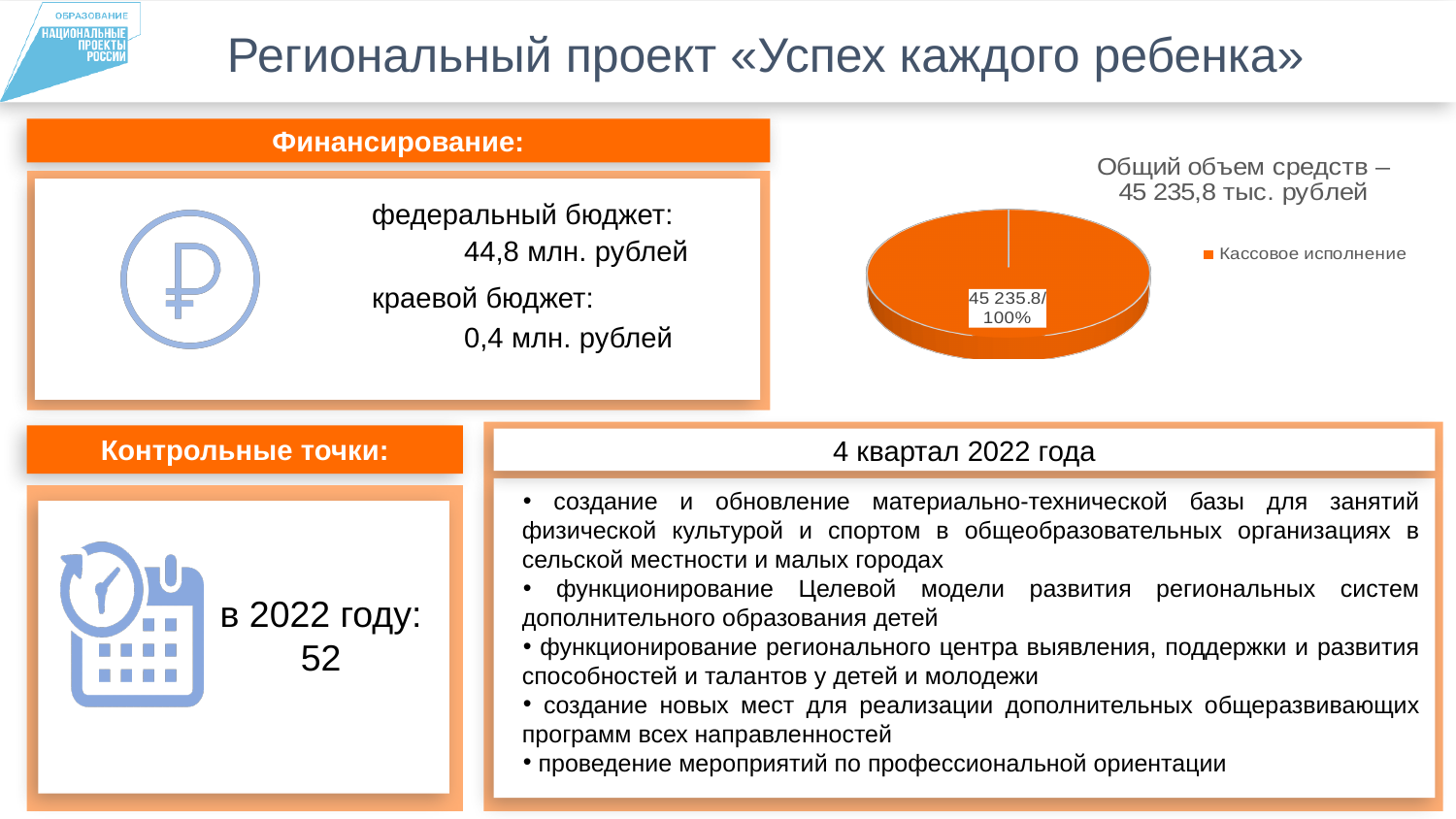
What total amount is stated in the pie chart's title? 45 235,8 тыс. рублей What is the value for Кассовое исполнение in the pie chart? 45 235.8 What value is printed on the pie chart's slice? 45 235.8 What is the legend entry of the pie chart? Кассовое исполнение How many entries does the pie chart's legend list? 1 What share of the pie does the slice labelled 45 235.8 represent? 100% What kind of chart is shown on the slide? pie chart How many slices does the pie chart have? 1